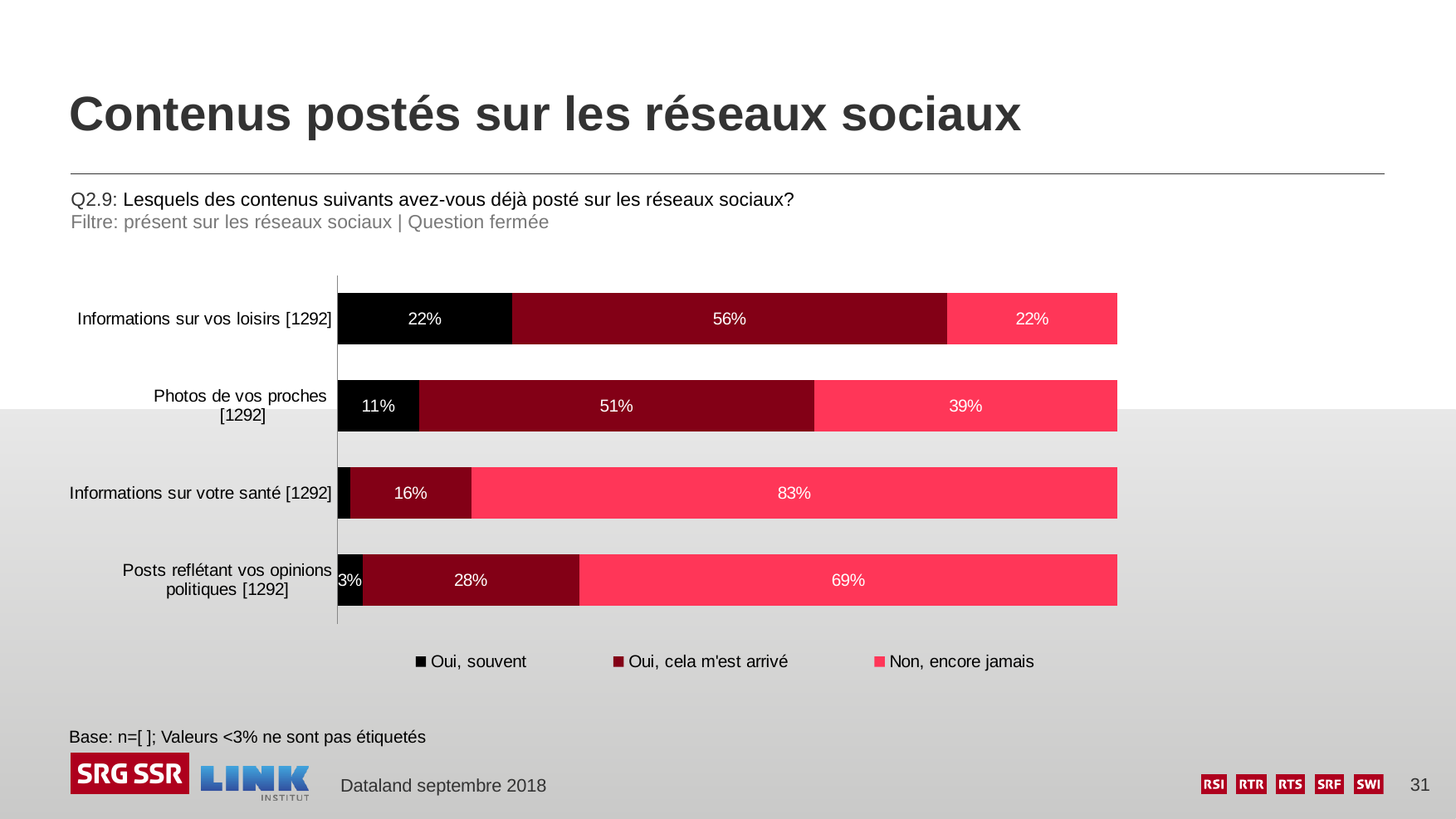
Which is larger: the "Oui, souvent" value for "Informations sur vos loisirs" or for "Photos de vos proches"? Informations sur vos loisirs Which category has the lowest value for "Oui, cela m'est arrivé"? Informations sur votre santé What is the value of "Non, encore jamais" for "Informations sur votre santé"? 83% What is the value of "Oui, souvent" for "Posts reflétant vos opinions politiques"? 3% How many categories are shown in the chart? 4 What kind of chart is shown on the slide? Stacked bar chart How many series does the legend list? 3 What is the sample size shown in brackets next to each category label? 1292 Which category has the highest value for "Non, encore jamais"? Informations sur votre santé What is the difference between the "Non, encore jamais" values for "Photos de vos proches" and "Informations sur vos loisirs"? 17% What is the value of "Oui, cela m'est arrivé" for "Photos de vos proches"? 51% What percentage of respondents answered "Oui, souvent" for "Informations sur vos loisirs"? 22%